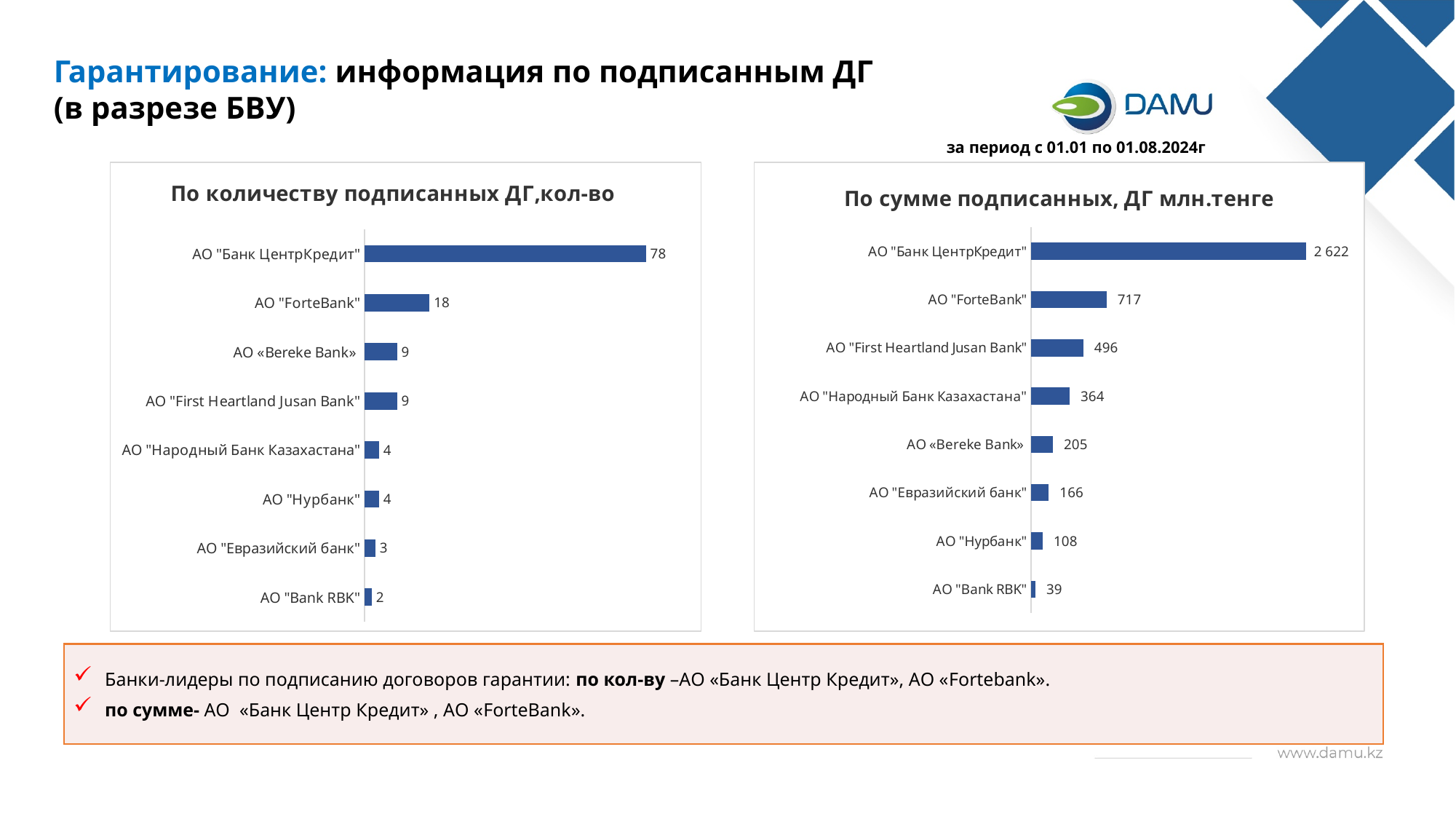
In the chart "По сумме подписанных, ДГ млн.тенге", which bank has the highest value? АО "Банк ЦентрКредит" In the chart "По сумме подписанных, ДГ млн.тенге", what is the difference between АО "ForteBank" and АО "Нурбанк"? 609 In the chart "По количеству подписанных ДГ,кол-во", how many banks are shown? 8 In the chart "По сумме подписанных, ДГ млн.тенге", what is the value for АО "First Heartland Jusan Bank"? 496 In the chart "По количеству подписанных ДГ,кол-во", what is the value for АО "ForteBank"? 18 In the chart "По количеству подписанных ДГ,кол-во", what is the value for АО "Банк ЦентрКредит"? 78 In the chart "По сумме подписанных, ДГ млн.тенге", what is the value for АО "Банк ЦентрКредит"? 2 622 In the chart "По сумме подписанных, ДГ млн.тенге", which is larger: АО "Народный Банк Казахастана" or АО «Bereke Bank»? АО "Народный Банк Казахастана" In the chart "По сумме подписанных, ДГ млн.тенге", what is the value for АО "Bank RBK"? 39 What type of chart is the chart "По сумме подписанных, ДГ млн.тенге"? Bar chart In the chart "По количеству подписанных ДГ,кол-во", which bank has the lowest value? АО "Bank RBK" In the chart "По количеству подписанных ДГ,кол-во", what is the difference between АО "Банк ЦентрКредит" and АО "ForteBank"? 60